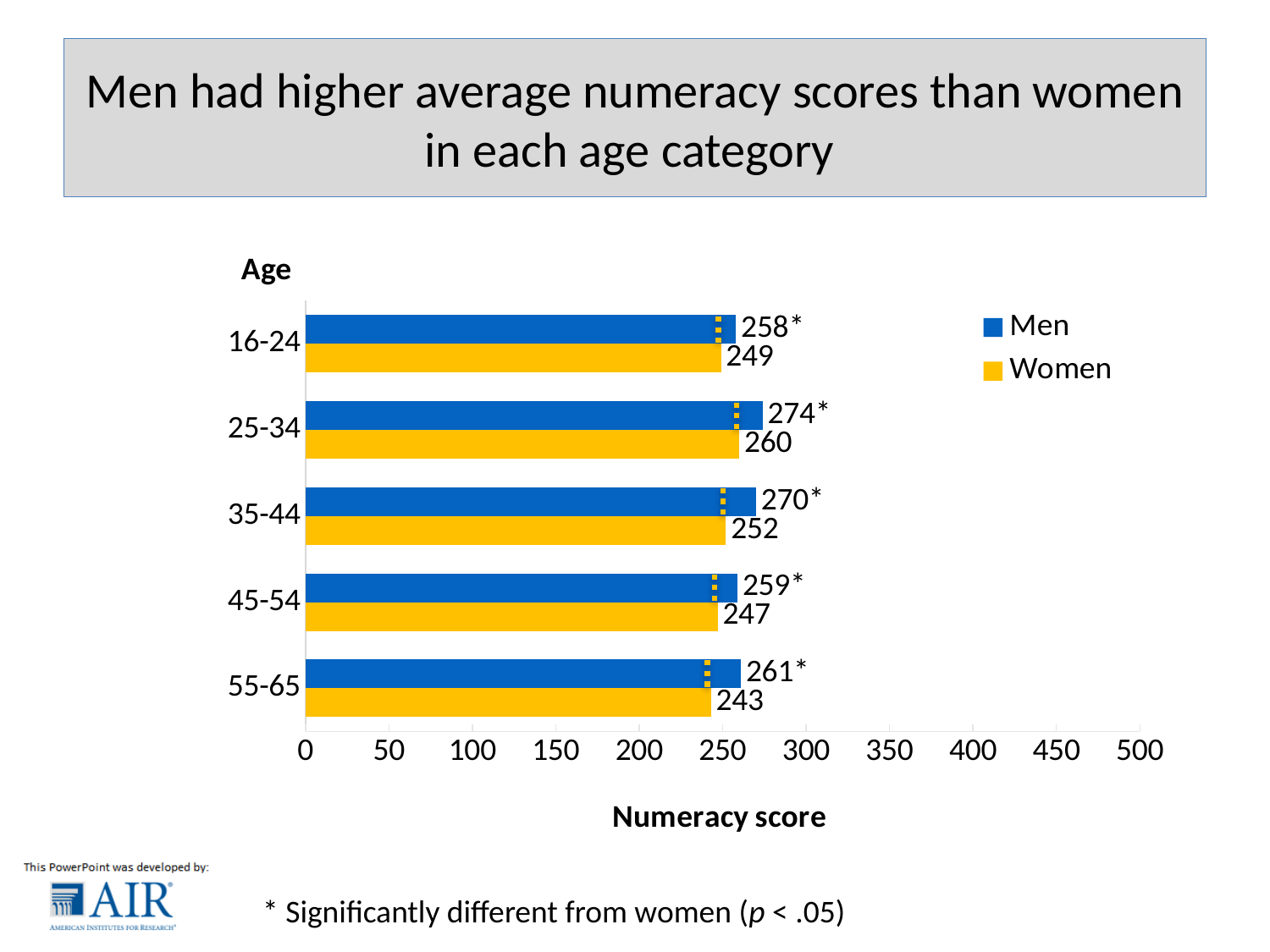
Which age category has the lowest average numeracy score for women? 55-65 How many age categories are shown on the chart? 5 What is the difference between the men's and women's average numeracy scores in the 35-44 age category? 18 How many series does the legend list? 2 What is the average numeracy score for women aged 16-24? 249 What is the average numeracy score for men aged 25-34? 274 Which age category has the highest average numeracy score for men? 25-34 What kind of chart is shown on the slide? Bar chart Which is larger: the women's score for ages 25-34 or the women's score for ages 45-54? Women's score for ages 25-34 Is the men's average numeracy score for ages 45-54 greater or less than 250? greater What is the difference between the men's and women's average numeracy scores in the 55-65 age category? 18 What is the average numeracy score for women aged 55-65? 243